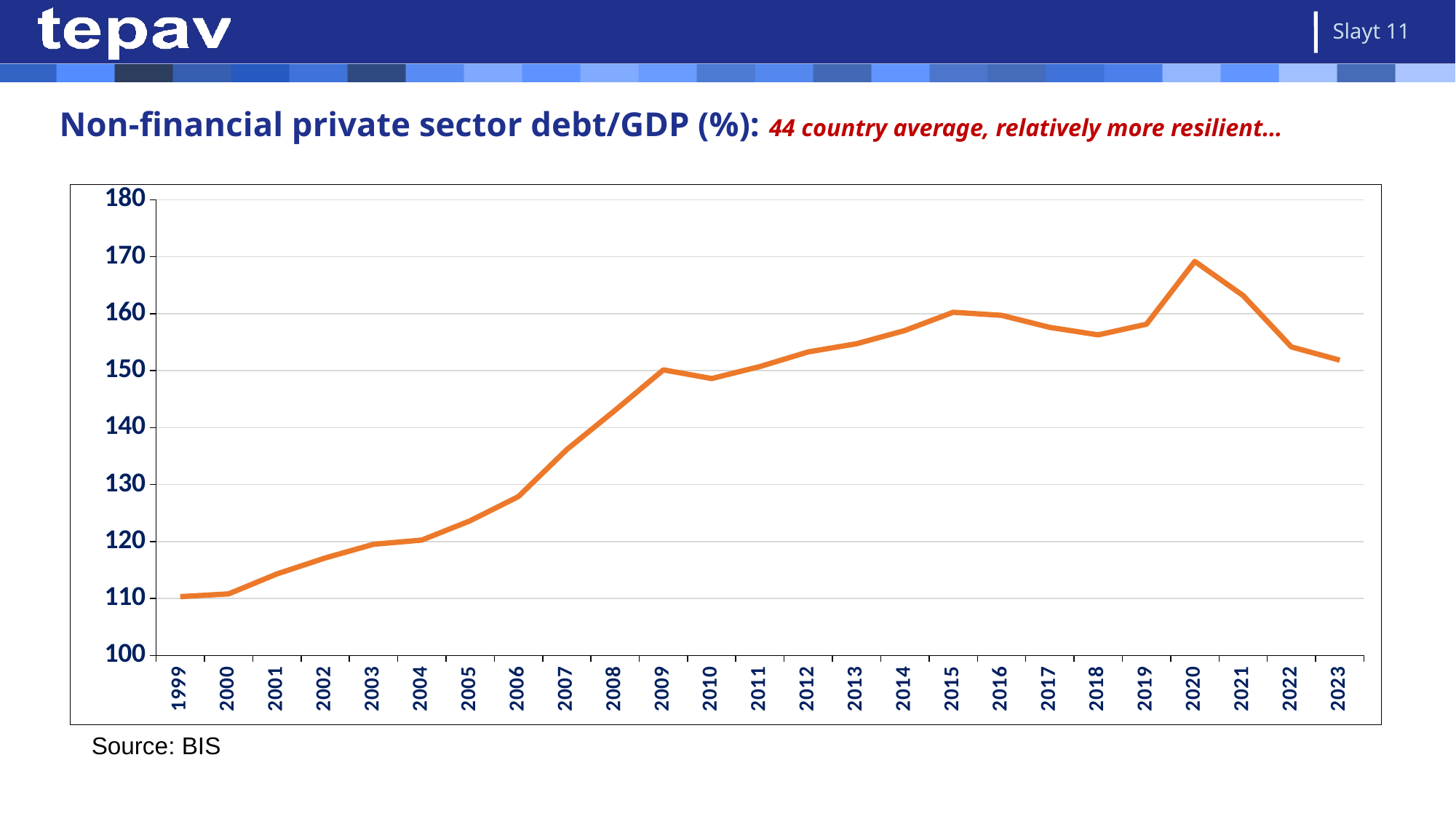
Is the value for 2009 greater or less than 140? greater How many years are plotted on the x axis? 25 Which year has the lowest non-financial private sector debt/GDP value? 1999 Which year has the larger value, 2021 or 2022? 2021 What is the source cited below the chart? BIS Is the value for 2001 greater or less than 120? less Is the value for 2020 greater or less than 160? greater What colour is the plotted line? orange Which year has the highest non-financial private sector debt/GDP value? 2020 Does the value rise or fall from 1999 to 2009? rise What kind of chart is shown on the slide? line chart